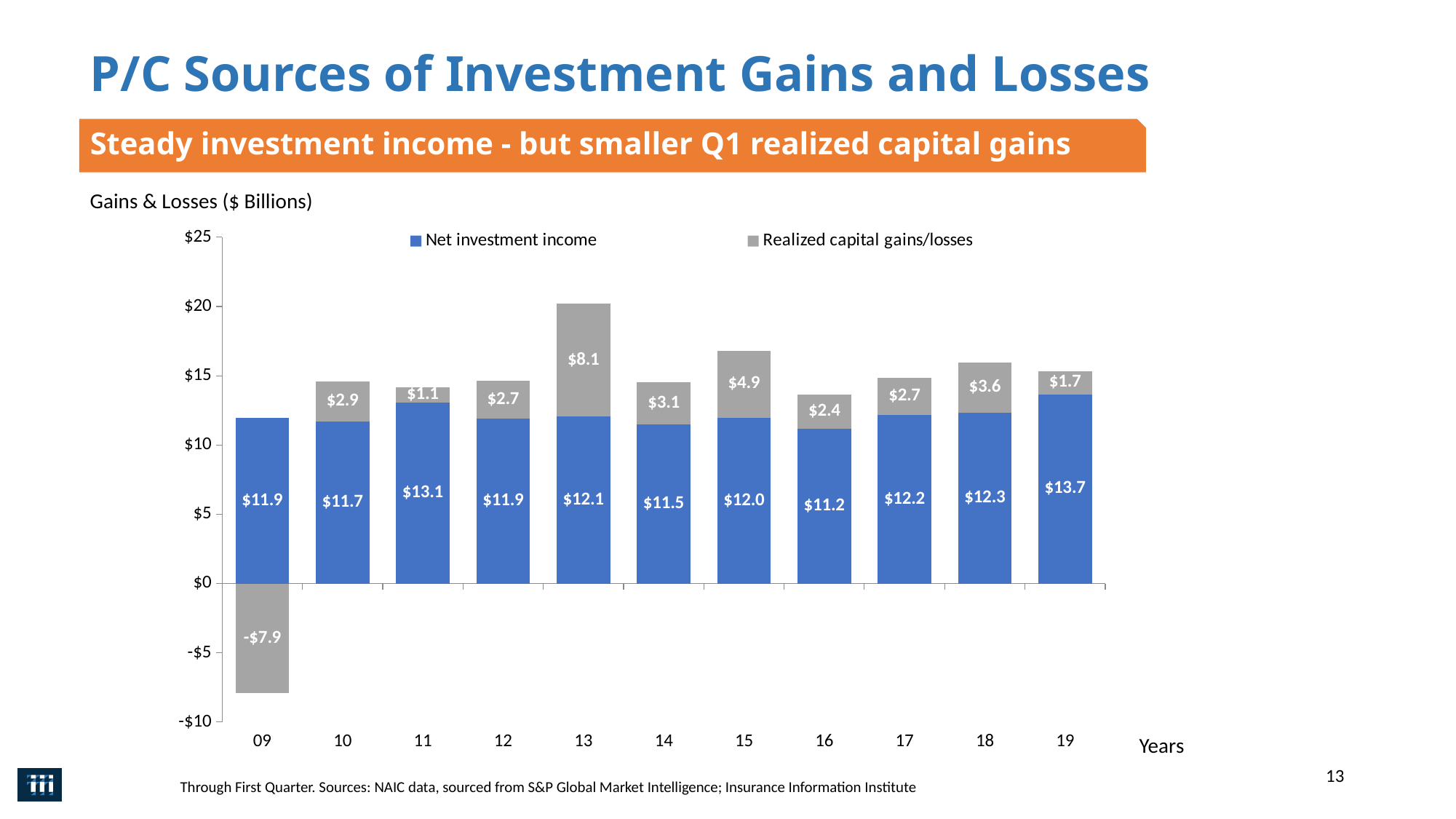
What kind of chart is shown on the slide? Stacked bar chart How many years are shown on the x axis? 11 How many series does the legend list? 2 What is the value of realized capital gains/losses for 13? $8.1 Which year has the highest net investment income? 19 Which year has larger realized capital gains/losses, 15 or 18? 15 Which year has the highest realized capital gains/losses? 13 Which year has the lowest net investment income? 16 What is the value of realized capital gains/losses for 09? -$7.9 What is the net investment income for 19? $13.7 What is the difference between net investment income in 19 and in 16? $2.5 What is the total of the stacked bar for 13? $20.2